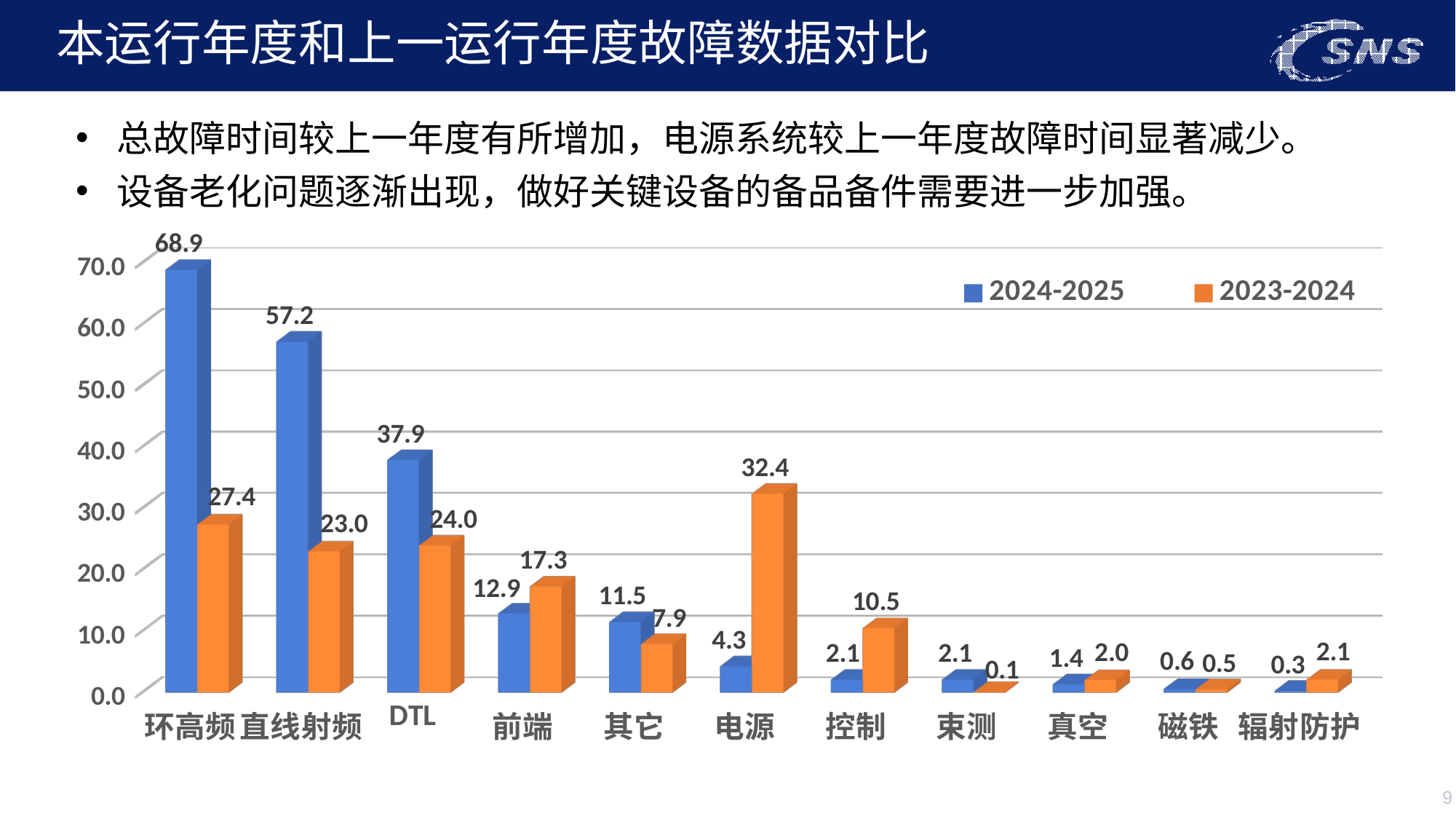
Which colour represents the 2023-2024 series in the legend? orange What is the 2023-2024 value for DTL? 24.0 Is the 2024-2025 value for DTL greater or less than 30.0? greater For 电源, which series has the larger value, 2024-2025 or 2023-2024? 2023-2024 How many series does the legend list? 2 What is the 2023-2024 value for 电源? 32.4 Which category has the highest 2024-2025 value? 环高频 What is the 2024-2025 value for 环高频? 68.9 Which category has the lowest 2023-2024 value? 束测 What is the difference between the 2024-2025 and 2023-2024 values for 直线射频? 34.2 What kind of chart is shown on the slide? bar chart How many categories are shown on the x axis? 11